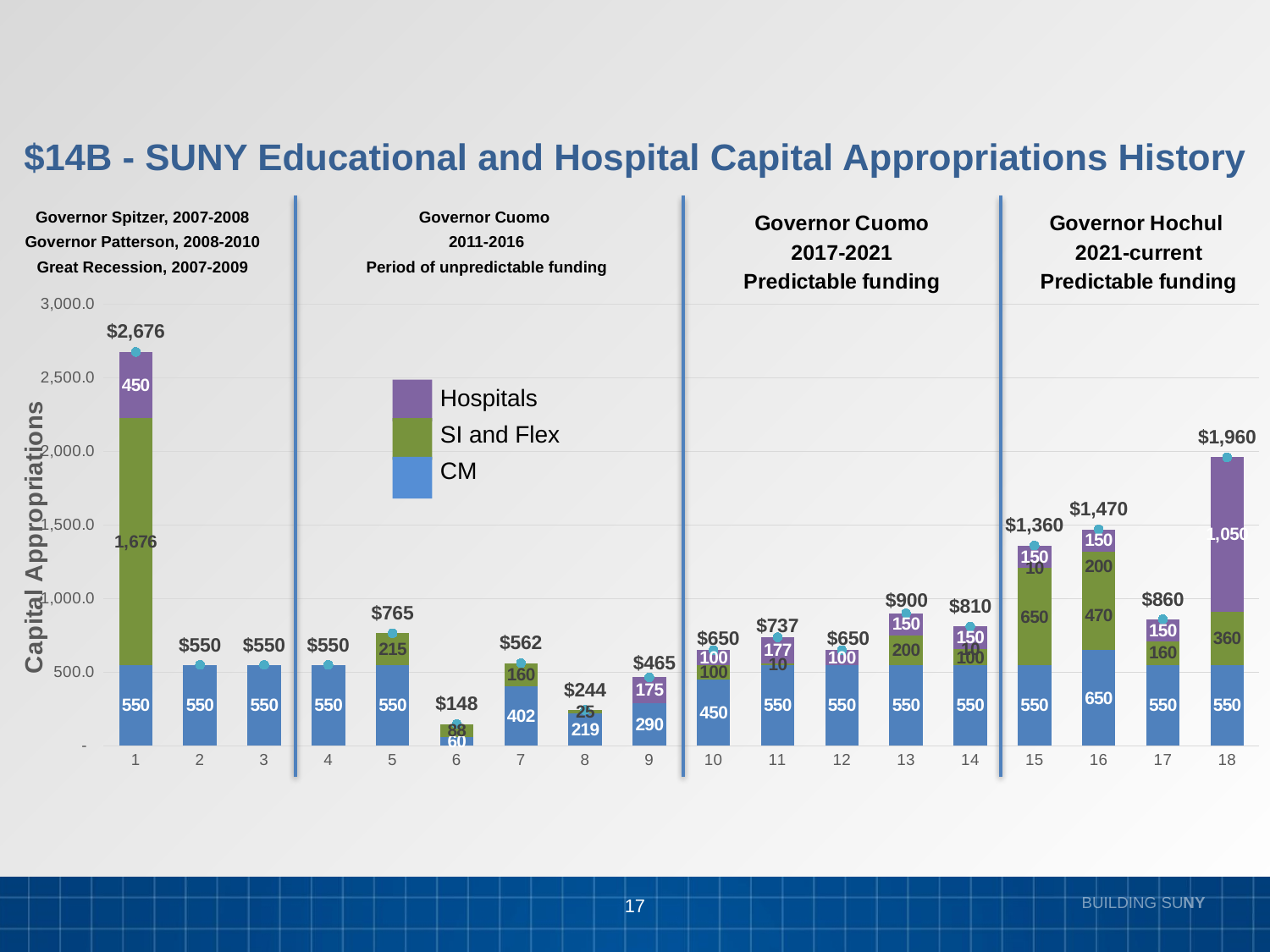
Which category has the lowest total capital appropriation? 6 ($148) What is the title of the y axis? Capital Appropriations How many series does the legend list? 3 What is the CM value for category 16? 650 Which has the larger total, category 13 or category 14? Category 13 What kind of chart is shown on the slide? Stacked bar chart What is the difference between the totals for category 16 and category 15? $110 Which category has the highest total capital appropriation? 1 ($2,676) What is the total labeled above the bar for category 18? $1,960 What is the SI and Flex value for category 1? 1,676 How many bars (categories) are plotted along the x axis? 18 What is the Hospitals value for category 18? 1,050